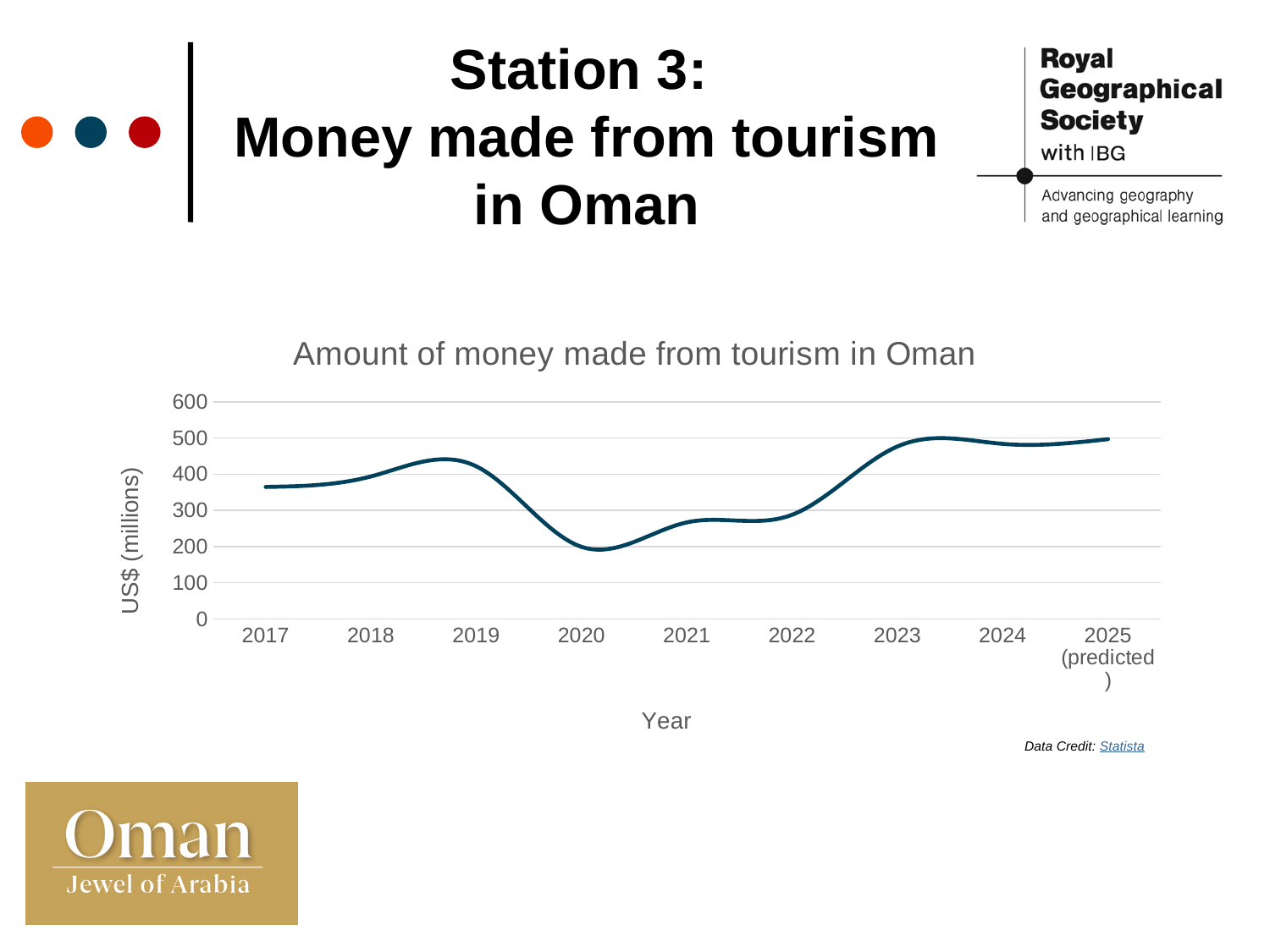
Does the value rise or fall between 2019 and 2020? fall Is the value for 2021 greater or less than 300? less What is the title of the chart? Amount of money made from tourism in Oman What kind of chart is shown on the slide? line chart Which year has the larger value, 2019 or 2020? 2019 Does the value rise or fall between 2022 and 2023? rise Is the value for 2023 greater or less than 400? greater Is the value for 2020 greater or less than 300? less How many years are plotted along the x axis of the chart? 9 Which year has the lowest value on the chart? 2020 What is the label on the vertical axis of the chart? US$ (millions)